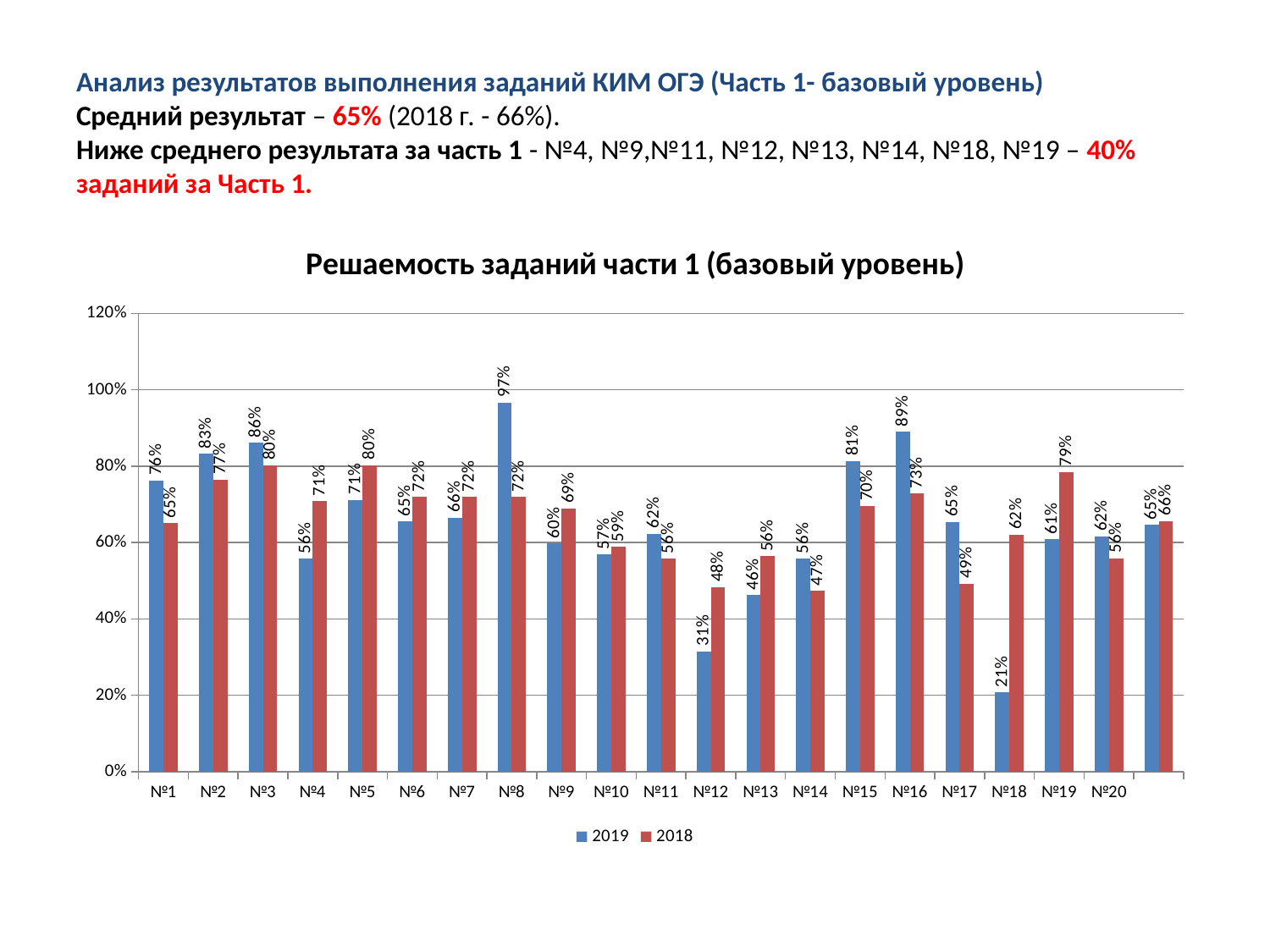
What kind of chart is shown on the slide? Bar chart Which task has the lowest 2019 value? №18 What is the 2019 value for №8? 97% What is the difference between the 2018 and 2019 values for №18? 41% What is the 2018 value for №19? 79% What is the 2019 value for №12? 31% For №15, which year has the larger value, 2019 or 2018? 2019 Which task has the highest 2019 value? №8 For №4, which year has the larger value, 2019 or 2018? 2018 What is the difference between the 2019 and 2018 values for №16? 16% How many series does the legend list? 2 Which task has the lowest 2018 value? №12